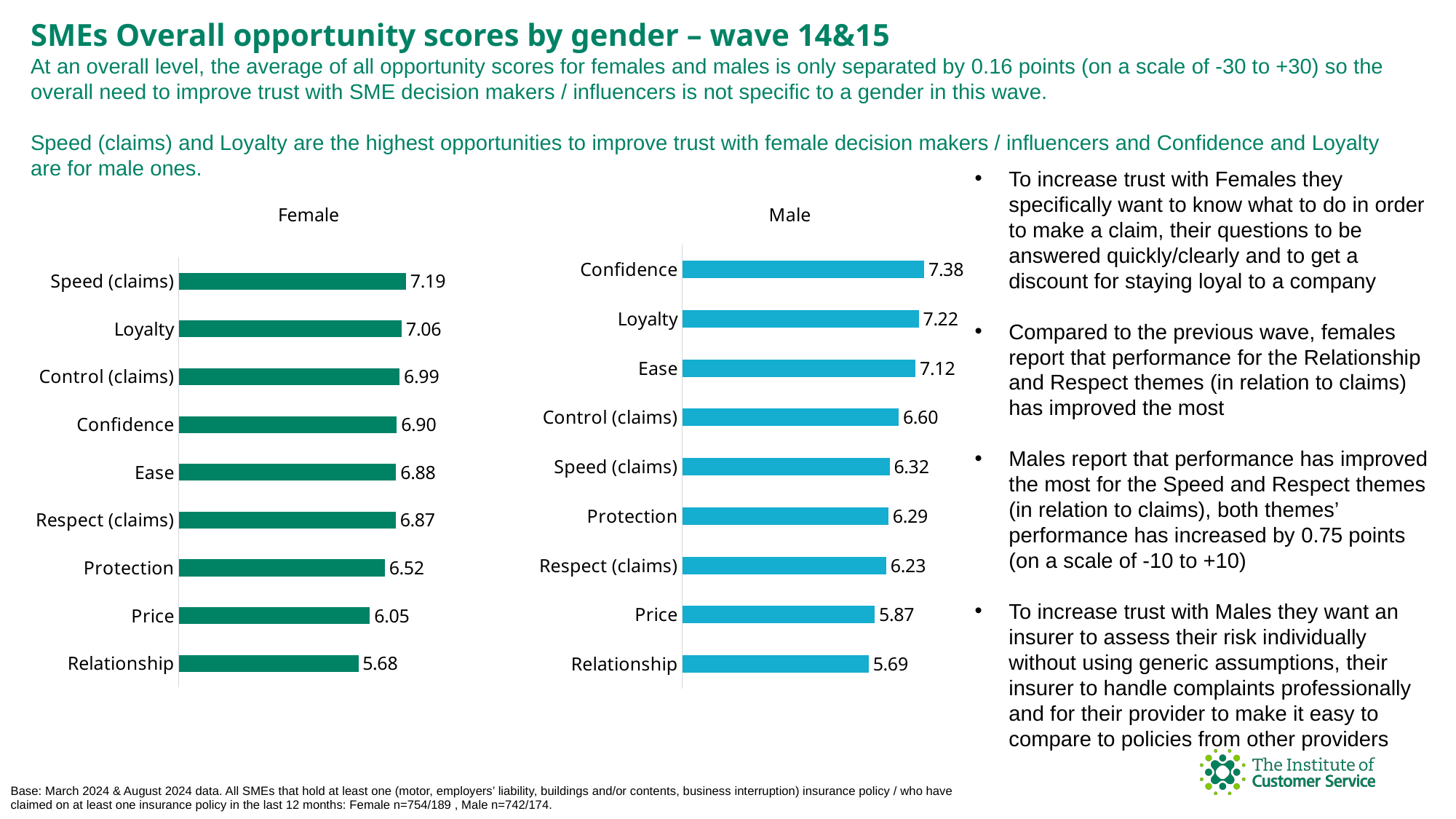
In the Female chart, which category has the lowest value? Relationship In the Female chart, what is the value for Speed (claims)? 7.19 In the Female chart, what is the difference between Loyalty and Price? 1.01 In the Male chart, what is the value for Confidence? 7.38 In the Male chart, what is the value for Ease? 7.12 Which is larger: the Female chart's value for Protection or the Male chart's value for Protection? Female (6.52) In the Male chart, what is the difference between Confidence and Relationship? 1.69 What colour are the bars in the Female chart? Dark green In the Male chart, which category has the highest value? Confidence How many categories are shown in the Female chart? 9 What kind of chart is the Male chart? Bar chart In the Female chart, which is larger: Confidence or Ease? Confidence